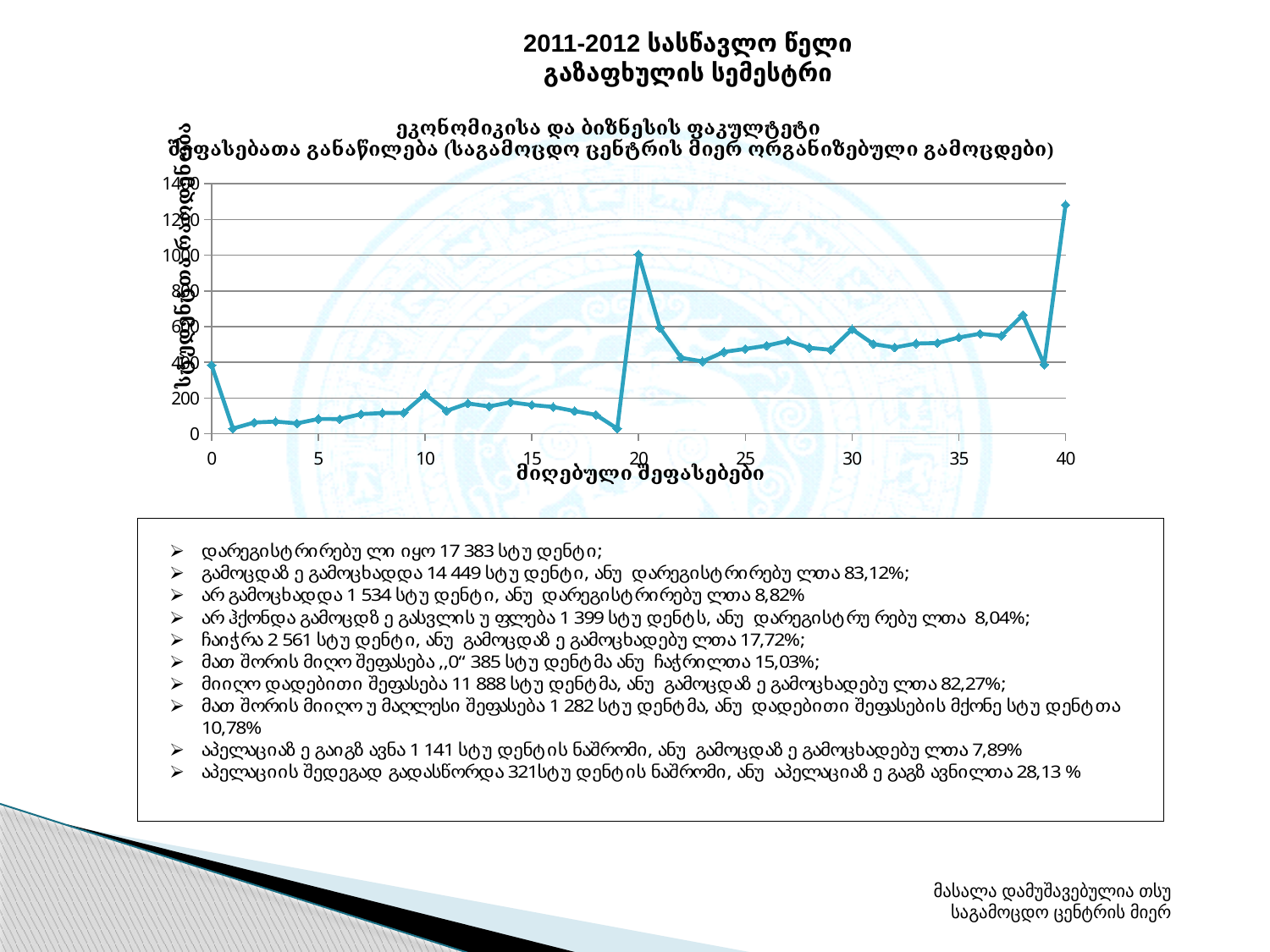
Is the value for score 20 greater or less than 800? greater At which score does the line reach its highest value? 40 Which has the larger value, score 5 or score 10? score 10 Is the value for score 10 greater or less than 400? less Is the value for score 30 greater or less than 800? less Which has the larger value, score 20 or score 30? score 20 What is the highest value shown on the y axis of the chart? 1400 Does the line rise or fall between score 20 and score 23? fall What kind of chart is shown on the slide? line chart What is the title of the x axis of the chart? მიღებული შეფასებები